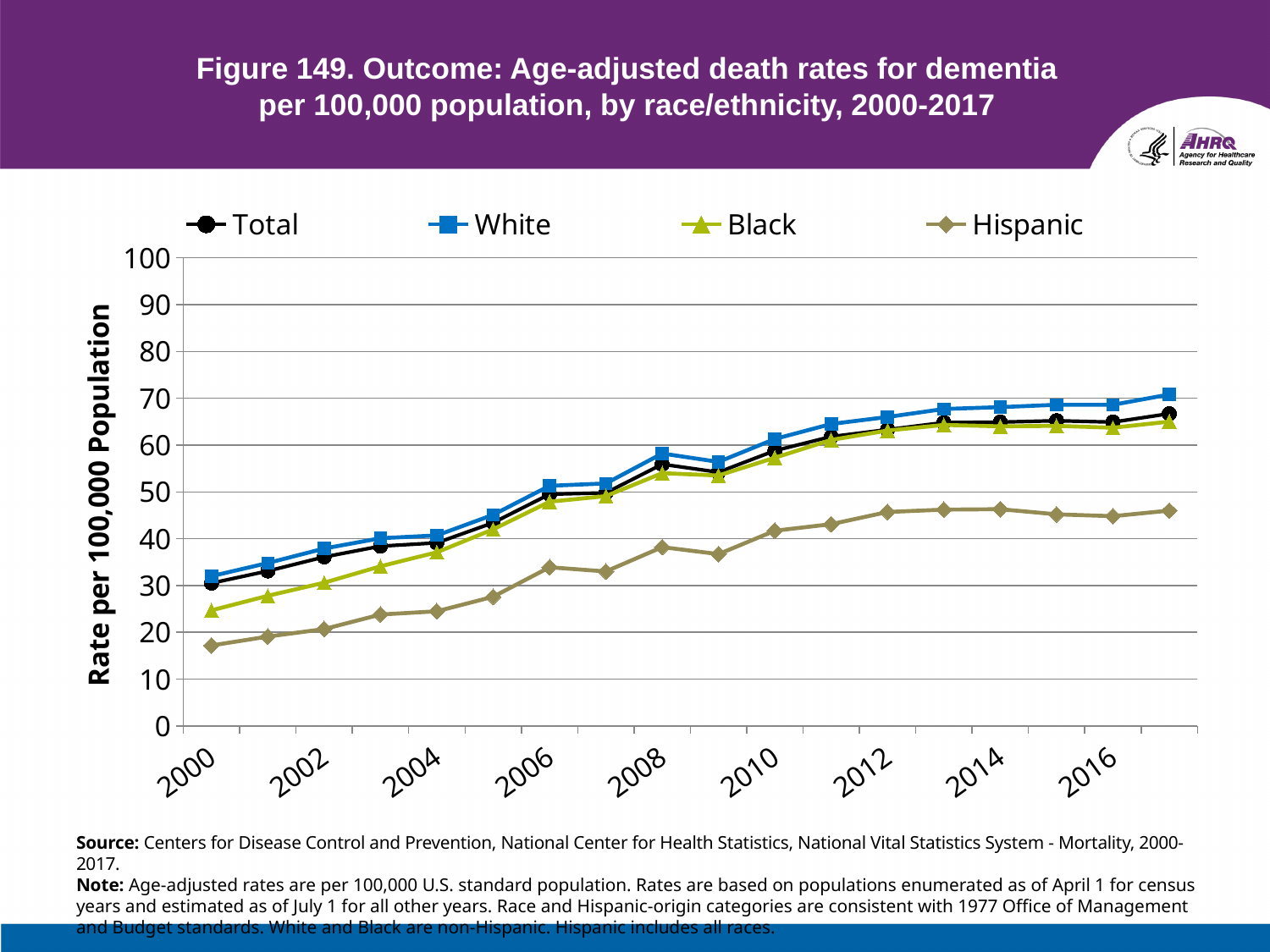
Is the value for Total in 2008 greater or less than 50? greater What is the label of the y axis? Rate per 100,000 Population Which is larger in 2000, the value for Black or the value for Hispanic? Black Do the death rates for the Total series generally rise or fall from 2000 to 2017? rise How many series does the legend list? 4 Which race/ethnicity group has the lowest death rate across the whole period? Hispanic What kind of chart is shown on the slide? line chart Which race/ethnicity group has the highest death rate in 2017? White Is the value for Hispanic in 2000 greater or less than 20? less How many years are plotted along the x axis? 18 Is the value for Hispanic in 2017 greater or less than 50? less